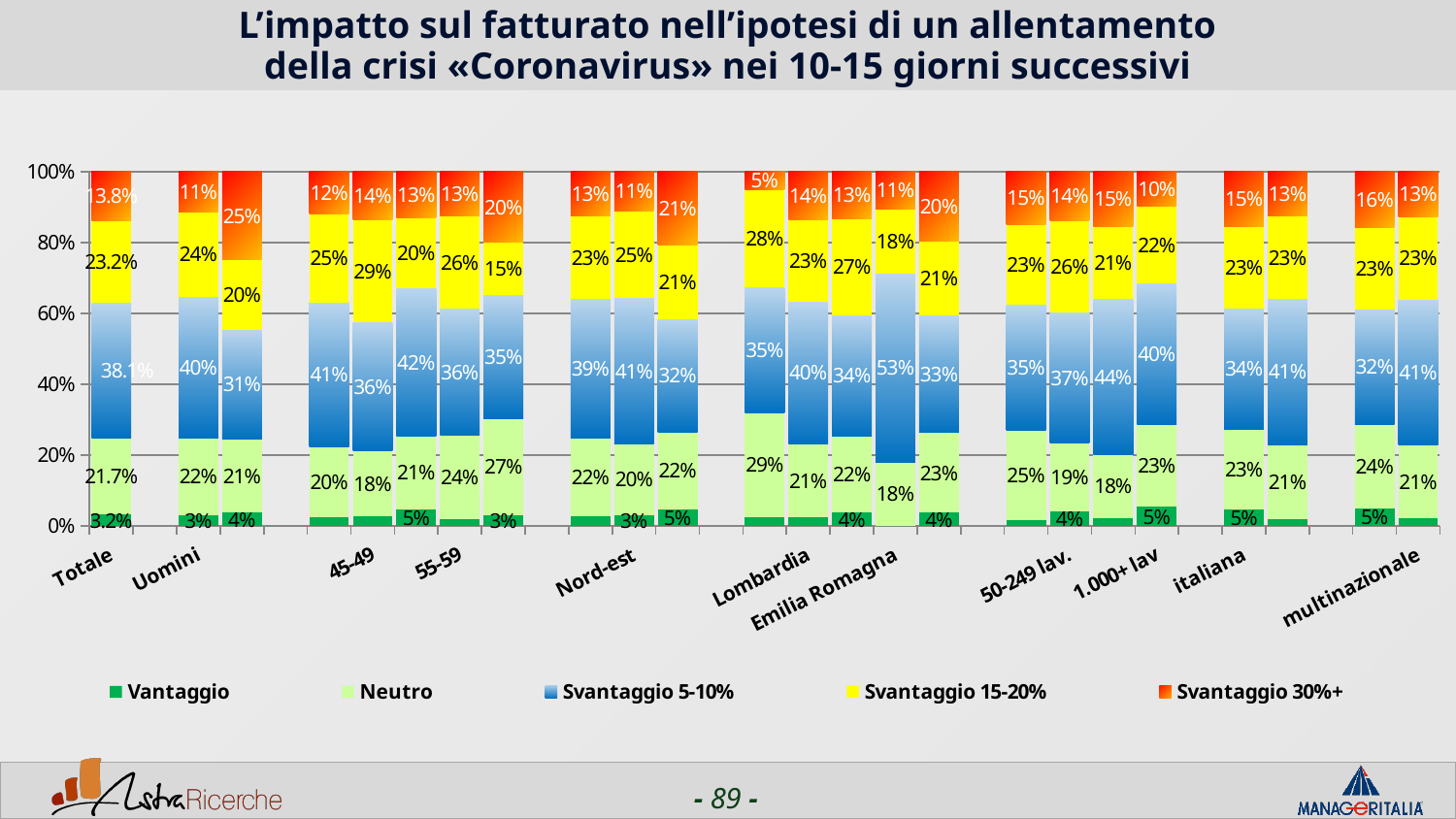
What is the value of 'Neutro' for the 'Totale' bar? 21.7% What is the value of 'Svantaggio 5-10%' for the 'Totale' bar? 38.1% In the 'Totale' bar, which is larger: 'Neutro' or 'Svantaggio 15-20%'? Svantaggio 15-20% Which series has the largest segment in the 'Totale' bar? Svantaggio 5-10% What is the value of 'Svantaggio 5-10%' for 'Uomini'? 40% Which legend entry is shown in orange-red? Svantaggio 30%+ What is the value of 'Vantaggio' for the 'Totale' bar? 3.2% How many series does the legend list? 5 What is the value of 'Svantaggio 30%+' for the 'Totale' bar? 13.8% What kind of chart is shown on the slide? Stacked bar chart What is the difference between 'Svantaggio 15-20%' and 'Svantaggio 30%+' in the 'Totale' bar? 9.4 percentage points What is the value of 'Svantaggio 5-10%' for 'Emilia Romagna'? 53%